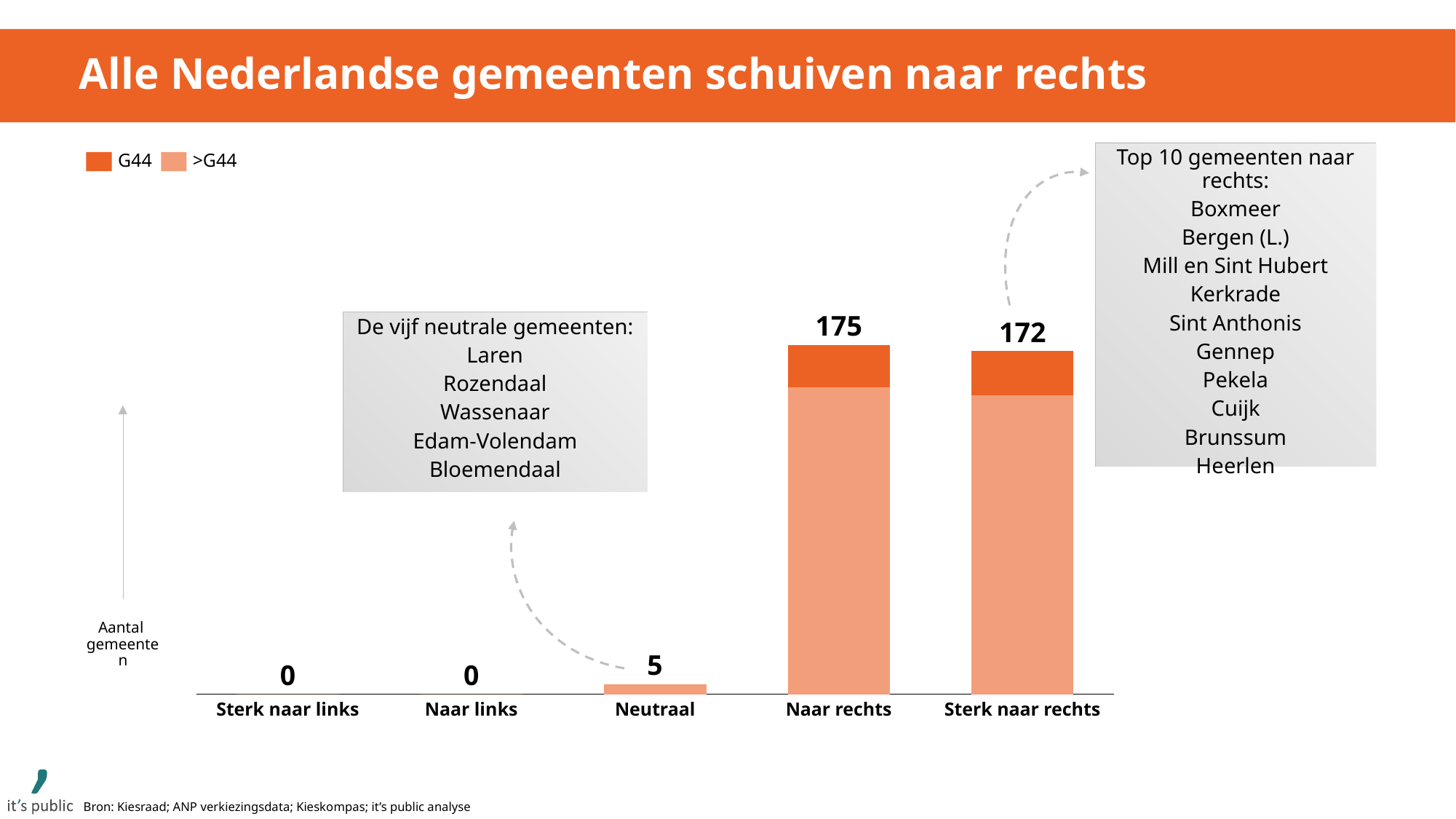
Which category has the highest total? Naar rechts What is the difference between the totals for 'Naar rechts' and 'Sterk naar rechts'? 3 What is the total number of municipalities shown for 'Sterk naar rechts'? 172 How many categories are shown on the x axis? 5 Which is larger, the total for 'Naar rechts' or for 'Sterk naar rechts'? Naar rechts What is the difference between the totals for 'Naar rechts' and 'Neutraal'? 170 What kind of chart is shown on the slide? Stacked bar chart How many series does the legend list? 2 What value is shown for 'Sterk naar links'? 0 What are the two series named in the legend? G44 and >G44 What value is shown for 'Neutraal'? 5 What is the total number of municipalities shown for 'Naar rechts'? 175